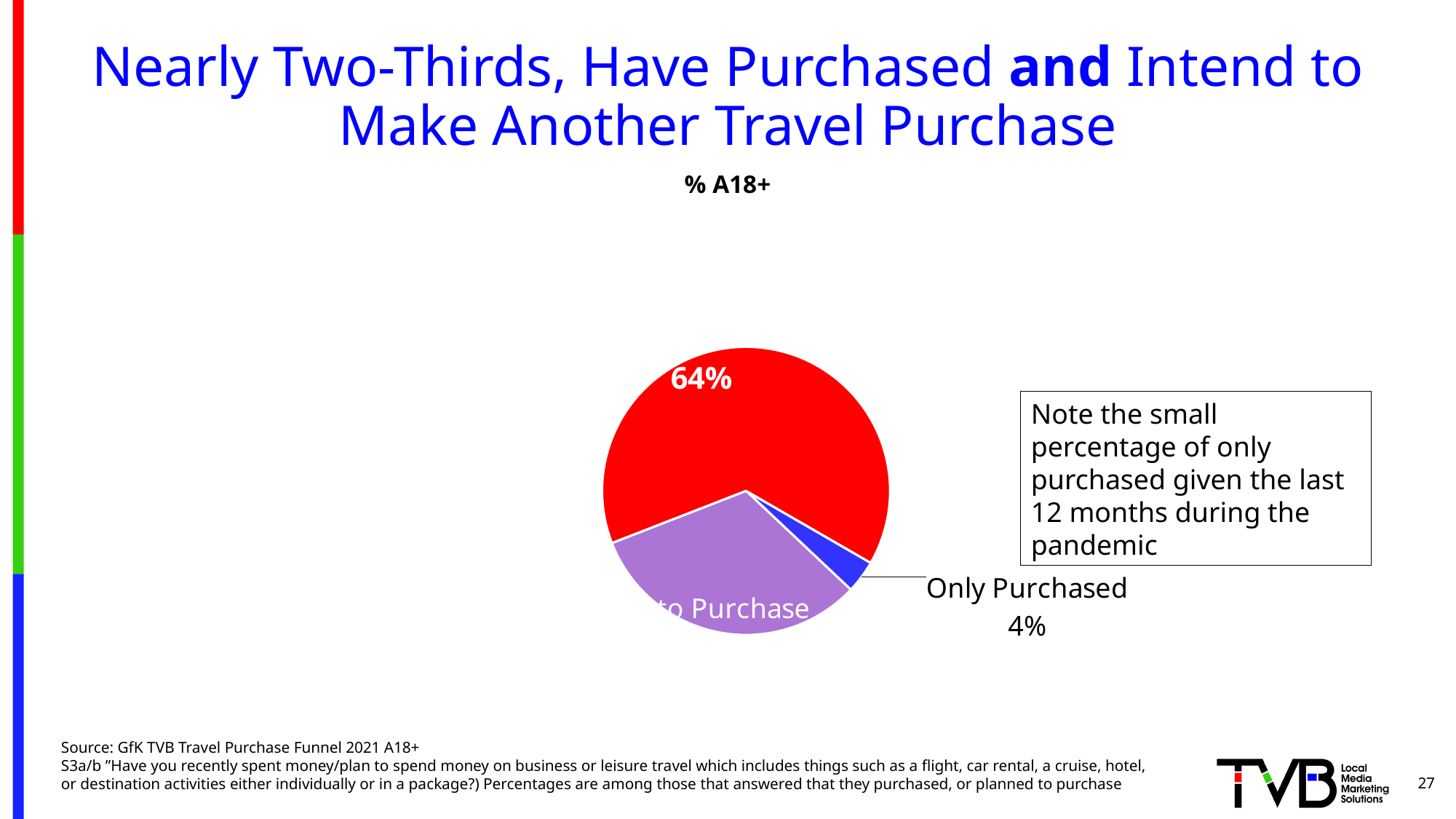
Is the Only Purchased slice larger or smaller than the red slice? smaller What kind of chart is shown on the slide? pie chart What label appears above the pie chart indicating the audience measured? % A18+ What is the difference between the red slice's value and the Only Purchased slice's value? 60% What percentage is printed on the red slice of the pie chart? 64% What percentage is shown for the Only Purchased slice? 4% What colour is the Only Purchased slice? blue How many slices does the pie chart have? 3 What share of the pie does the Only Purchased slice represent? 4% Which slice of the pie chart is the smallest? Only Purchased Is the red slice greater or less than 50% of the pie? greater